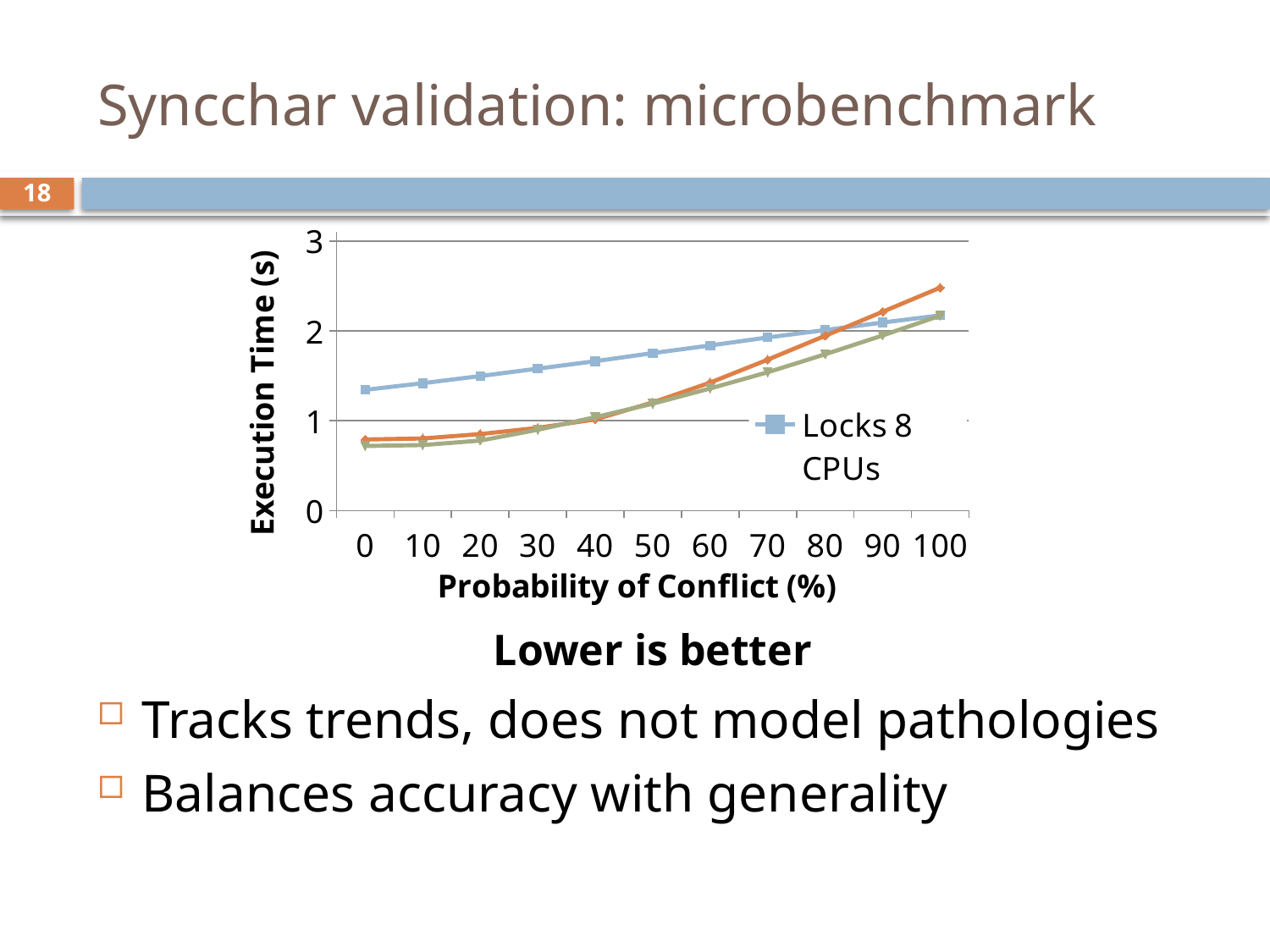
At 0% probability of conflict, is the Locks 8 CPUs line above or below the other two lines? above Is the value for Locks 8 CPUs at 100% probability of conflict greater or less than 2? greater At which probability of conflict does the Locks 8 CPUs line have its lowest execution time? 0 Does the Locks 8 CPUs line rise or fall as the probability of conflict increases? rises Is the value for Locks 8 CPUs at 0% probability of conflict greater or less than 1? greater How many points are plotted along the x axis for each line (from 0 to 100)? 11 At which probability of conflict does the Locks 8 CPUs line reach its highest execution time? 100 What kind of chart is shown on the slide? line chart Is the value for Locks 8 CPUs at 50% probability of conflict greater or less than 2? less How many lines are plotted on the chart? 3 What is the title of the x axis of the chart? Probability of Conflict (%) What is the title of the y axis of the chart? Execution Time (s)